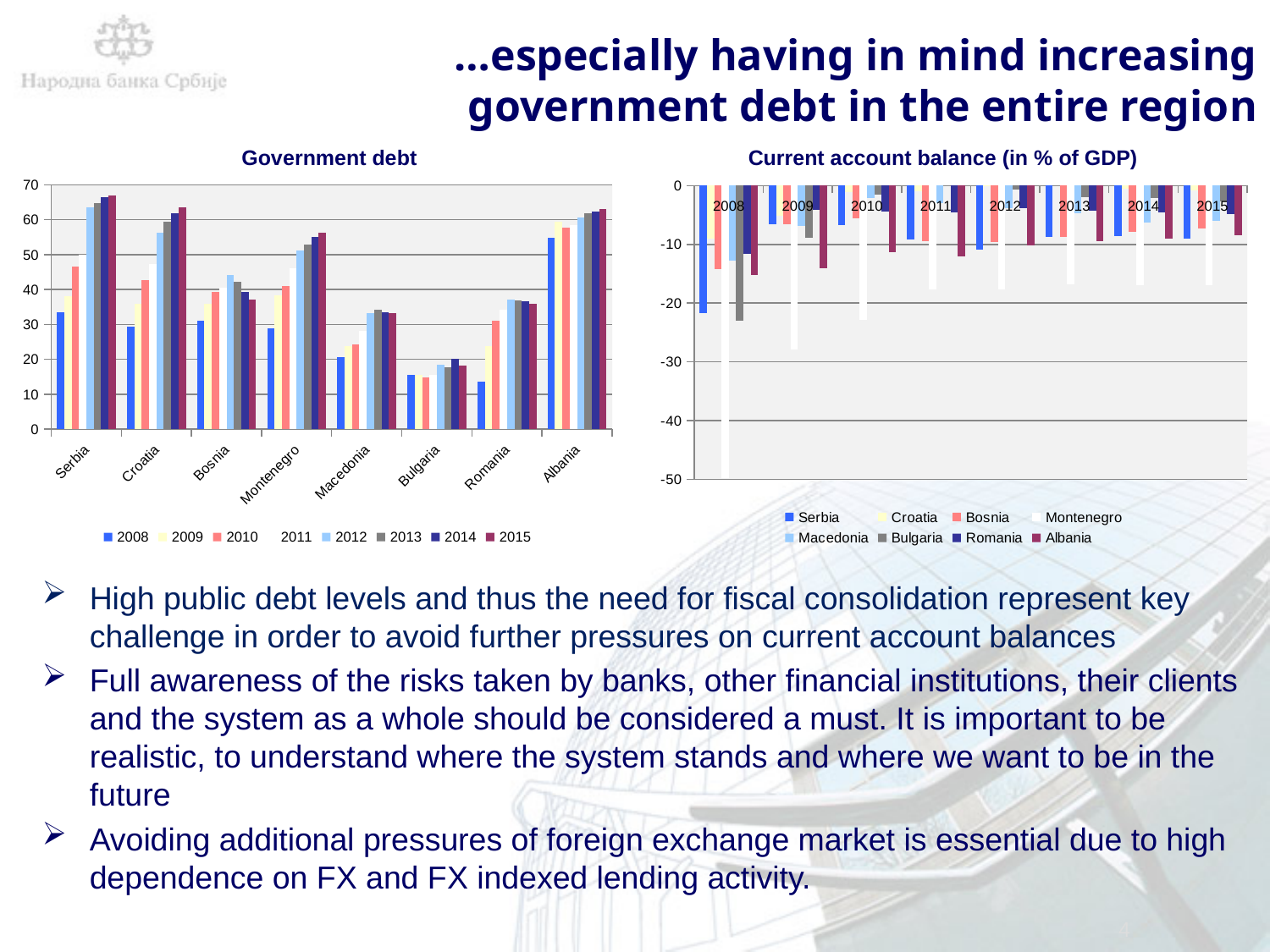
In the Government debt chart, is the value for Montenegro in 2015 greater or less than 50? greater In the Government debt chart, does Serbia's government debt rise or fall from 2008 to 2015? rise How many years does the legend of the Government debt chart list? 8 In the Government debt chart, is the value for Bulgaria in 2008 greater or less than 20? less In the Government debt chart, is the value for Serbia in 2015 greater or less than 60? greater In the Government debt chart, which country has the lowest government debt in 2015? Bulgaria How many countries does the legend of the Current account balance chart list? 8 In the Current account balance chart, which country has the lowest current account balance in 2008? Montenegro In the Government debt chart, which is larger in 2008: Serbia or Romania? Serbia What kind of chart is the Government debt chart? bar chart How many countries are shown on the x axis of the Government debt chart? 8